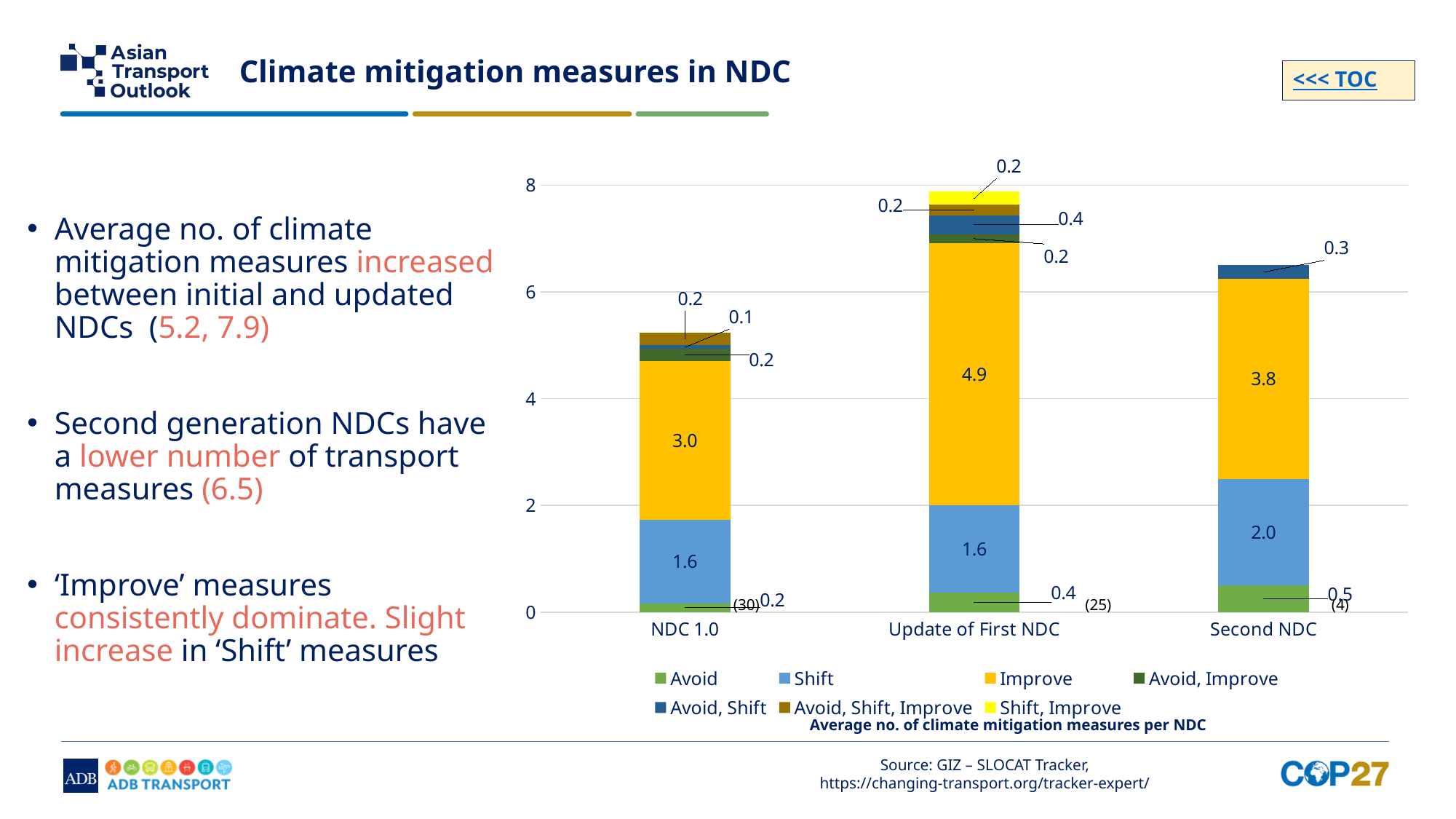
What is the difference between the 'Improve' values for Update of First NDC and NDC 1.0? 1.9 Which NDC category has the lowest 'Avoid' value? NDC 1.0 What is the value of the 'Improve' segment for Update of First NDC? 4.9 What is the value of the 'Shift' segment for Second NDC? 2.0 How many NDC categories are shown on the x axis of the chart? 3 Which NDC category has the highest 'Improve' value? Update of First NDC What is the total of the stacked bar for Update of First NDC? 7.9 How many series does the chart legend list? 7 What is the value of the 'Avoid, Shift' segment for Second NDC? 0.3 Is the total height of the NDC 1.0 bar greater or less than 6? less Which is larger, the 'Shift' value for Second NDC or for NDC 1.0? Second NDC What kind of chart is shown on the slide? Stacked bar chart